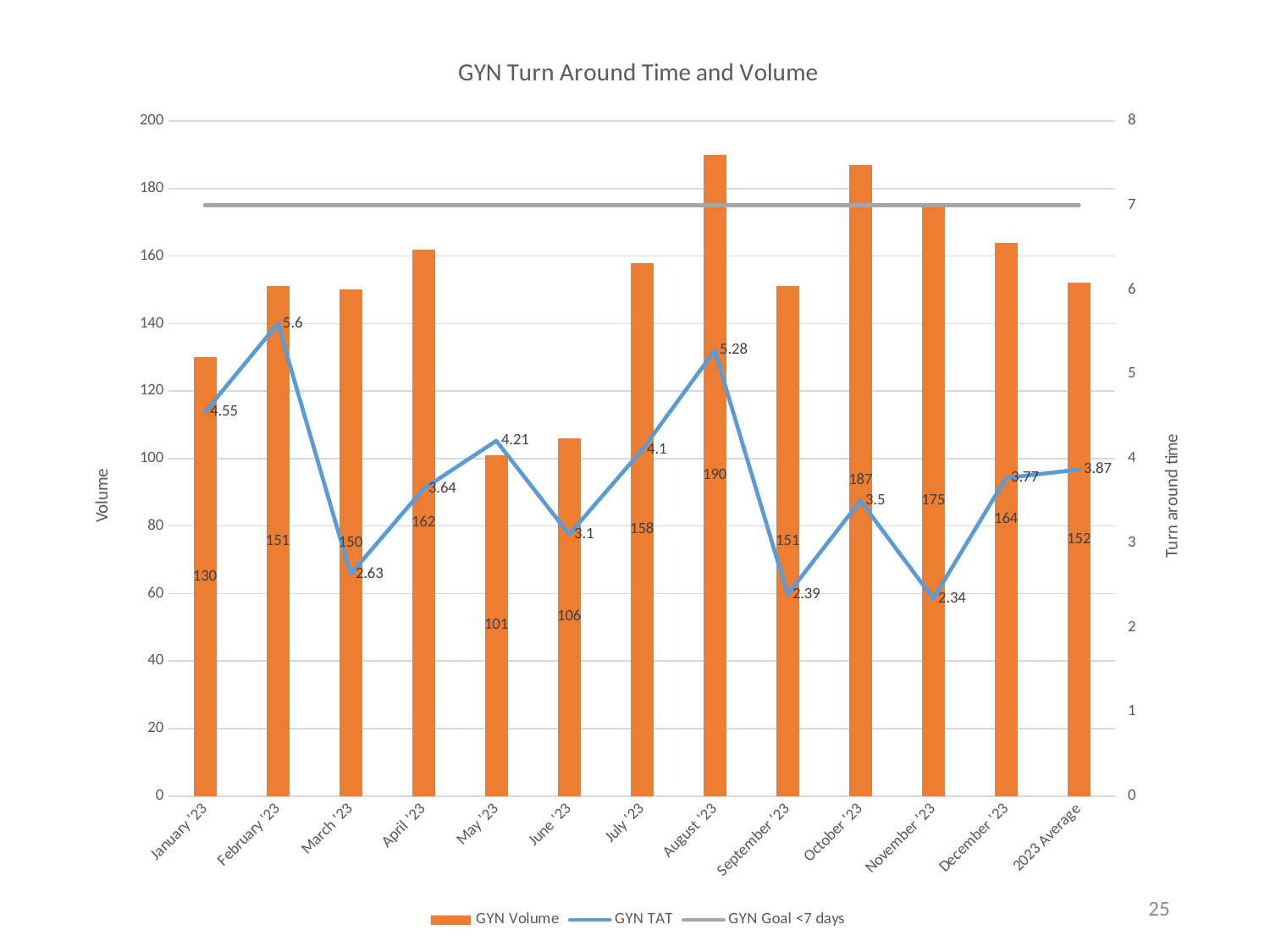
What is the GYN Volume for August '23? 190 Which month has the lowest GYN TAT? November '23 What is the difference in GYN Volume between October '23 and September '23? 36 What is the title of the chart? GYN Turn Around Time and Volume How many series does the legend list? 3 What is the GYN TAT value for February '23? 5.6 Which is larger, the GYN TAT for January '23 or for May '23? January '23 How many categories are shown on the x axis? 13 What is the GYN TAT value for the 2023 Average? 3.87 Which month has the highest GYN Volume? August '23 What type of chart is used to show GYN Volume? Bar chart Which month has the lowest GYN Volume? May '23